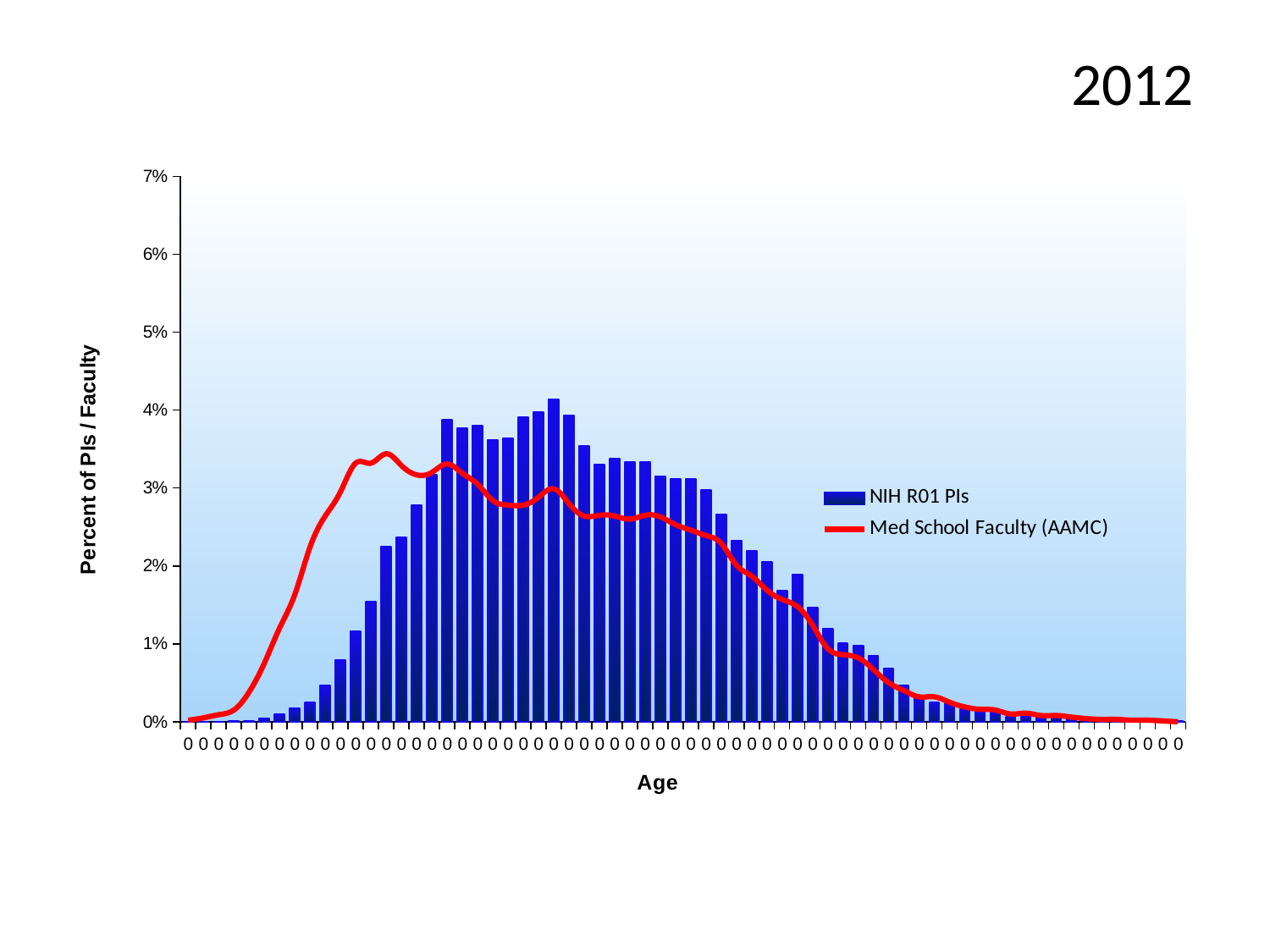
What kind of chart is shown on the slide? A bar chart with a line overlay What are the two series named in the legend? NIH R01 PIs and Med School Faculty (AAMC) Toward the right end of the Age axis, do the NIH R01 PIs bar values rise or fall? fall Is the highest NIH R01 PIs bar greater or less than 4%? greater Which series reaches its peak further to the left along the Age axis? Med School Faculty (AAMC) Is the peak of the Med School Faculty (AAMC) line greater or less than 3%? greater Is the peak of the Med School Faculty (AAMC) line greater or less than 4%? less What is the title of the vertical axis? Percent of PIs / Faculty Which series reaches the higher peak value, NIH R01 PIs or Med School Faculty (AAMC)? NIH R01 PIs How many series does the legend list? 2